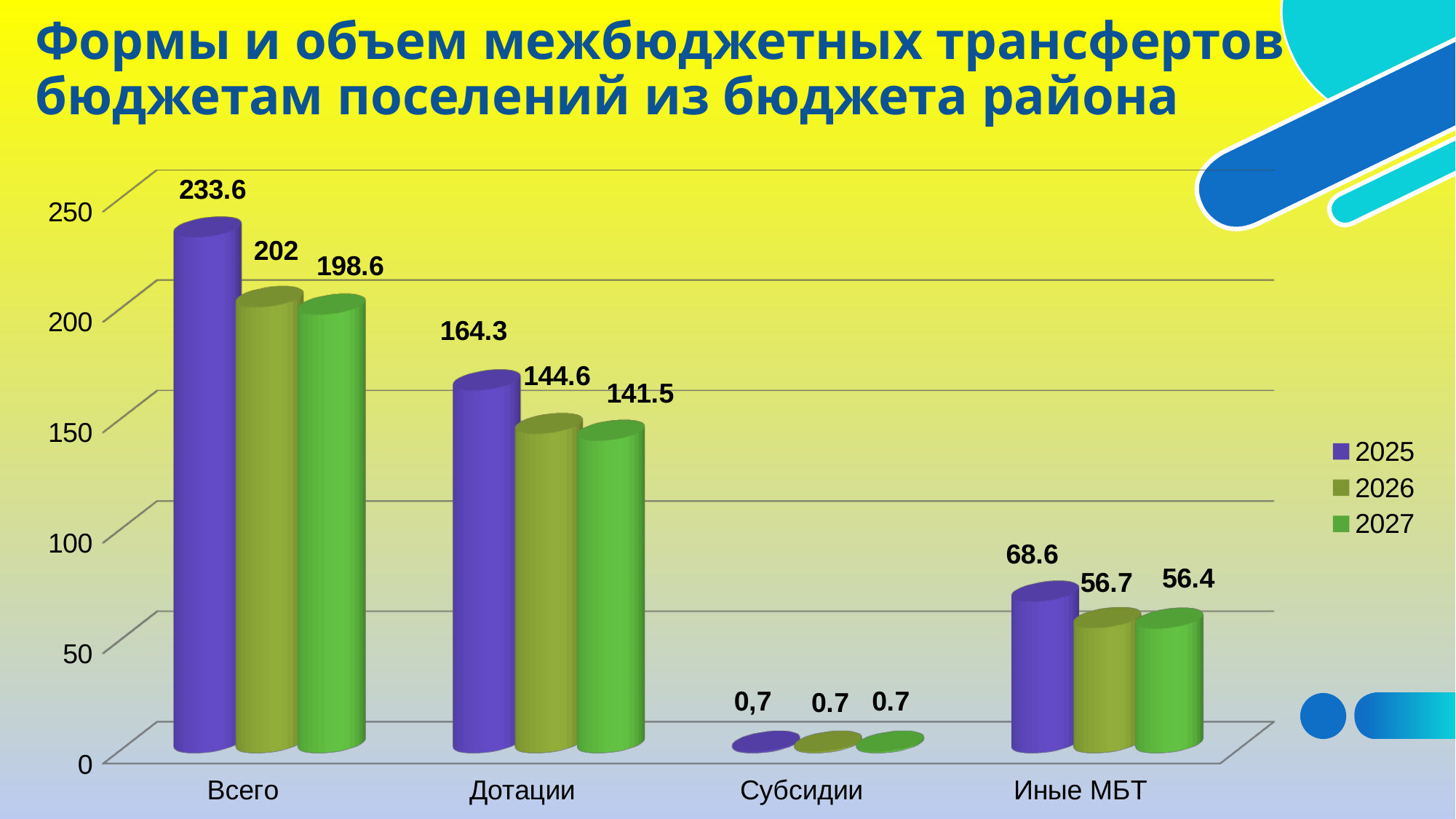
How many series does the legend list? 3 Do the values for Дотации rise or fall from 2025 to 2027? Fall Which is larger: Дотации in 2026 or Иные МБТ in 2025? Дотации in 2026 What is the value for Всего in 2025? 233.6 What is the value for Иные МБТ in 2026? 56.7 What is the value for Дотации in 2027? 141.5 Which category has the lowest values across all years? Субсидии What is the difference between the 2025 and 2026 values for Всего? 31.6 What is the difference between the 2025 and 2027 values for Иные МБТ? 12.2 What kind of chart is shown on the slide? Bar chart Which year has the highest value for Всего? 2025 How many categories are shown on the x axis? 4